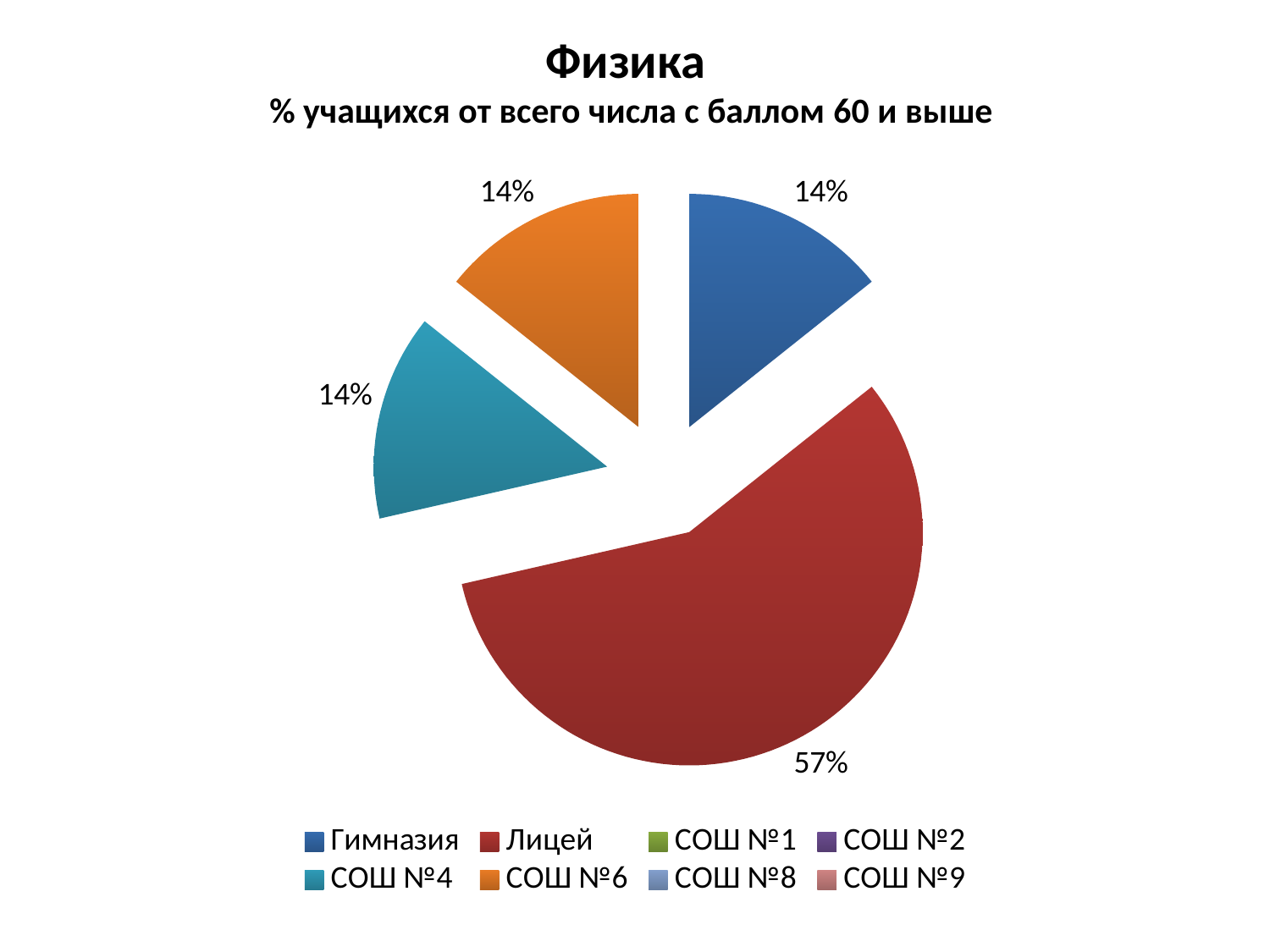
Which is larger, the slice for Лицей or the slice for СОШ №6? Лицей What is the title of the chart? Физика What kind of chart is shown on the slide? pie chart Which category has the largest slice of the pie? Лицей How many entries does the legend list? 8 What share of the pie does СОШ №4 have? 14% What colour is the slice for Лицей? red What share of the pie does Гимназия have? 14% What share of the pie does СОШ №6 have? 14% What is the difference in percentage points between the Лицей slice and the Гимназия slice? 43 How many slices are visible in the pie chart? 4 What share of the pie does Лицей have? 57%